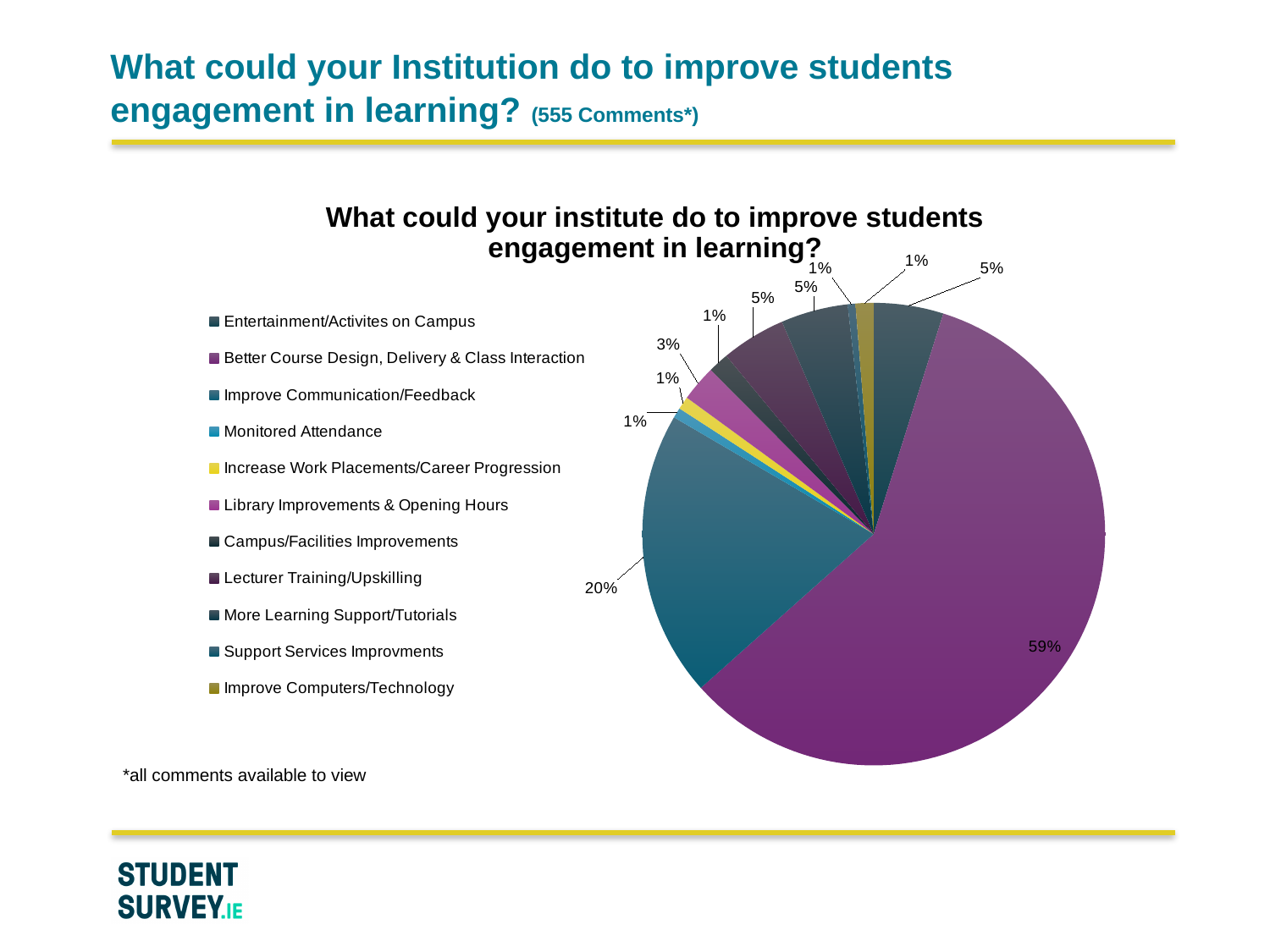
What is the title of the chart? What could your institute do to improve students engagement in learning? What share of the pie is 'Library Improvements & Opening Hours'? 3% What share of the pie is 'Better Course Design, Delivery & Class Interaction'? 59% How many comments does the slide title say the chart is based on? 555 Which is larger: the slice for 'Improve Communication/Feedback' or the slice for 'Library Improvements & Opening Hours'? Improve Communication/Feedback Which category has the largest slice of the pie? Better Course Design, Delivery & Class Interaction What type of chart is shown on the slide? pie chart How many categories does the legend of the pie chart list? 11 What share of the pie is 'Lecturer Training/Upskilling'? 5% What is the difference in percentage points between 'Better Course Design, Delivery & Class Interaction' and 'Improve Communication/Feedback'? 39 percentage points